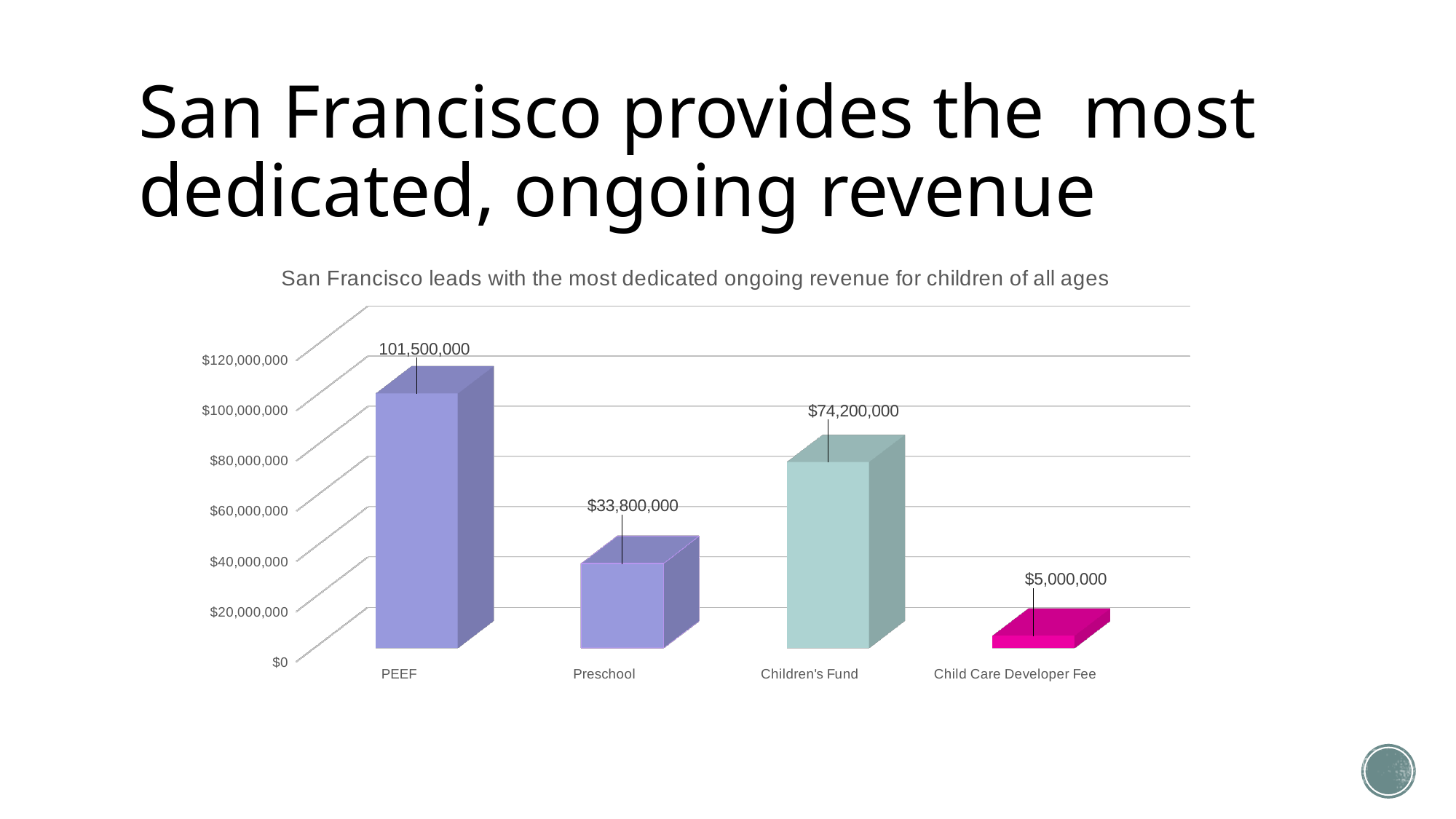
How many categories are shown on the x axis? 4 Is the value for Preschool greater or less than $40,000,000? less What is the difference between the values for Children's Fund and Preschool? $40,400,000 Which category has the lowest value? Child Care Developer Fee Which category has the highest value? PEEF What kind of chart is shown on the slide? bar chart What is the value shown for Children's Fund? $74,200,000 What is the value shown for Preschool? $33,800,000 What is the title of the chart? San Francisco leads with the most dedicated ongoing revenue for children of all ages Which is larger, the value for Preschool or the value for Children's Fund? Children's Fund What is the value shown for Child Care Developer Fee? $5,000,000 What is the value shown for PEEF? 101,500,000